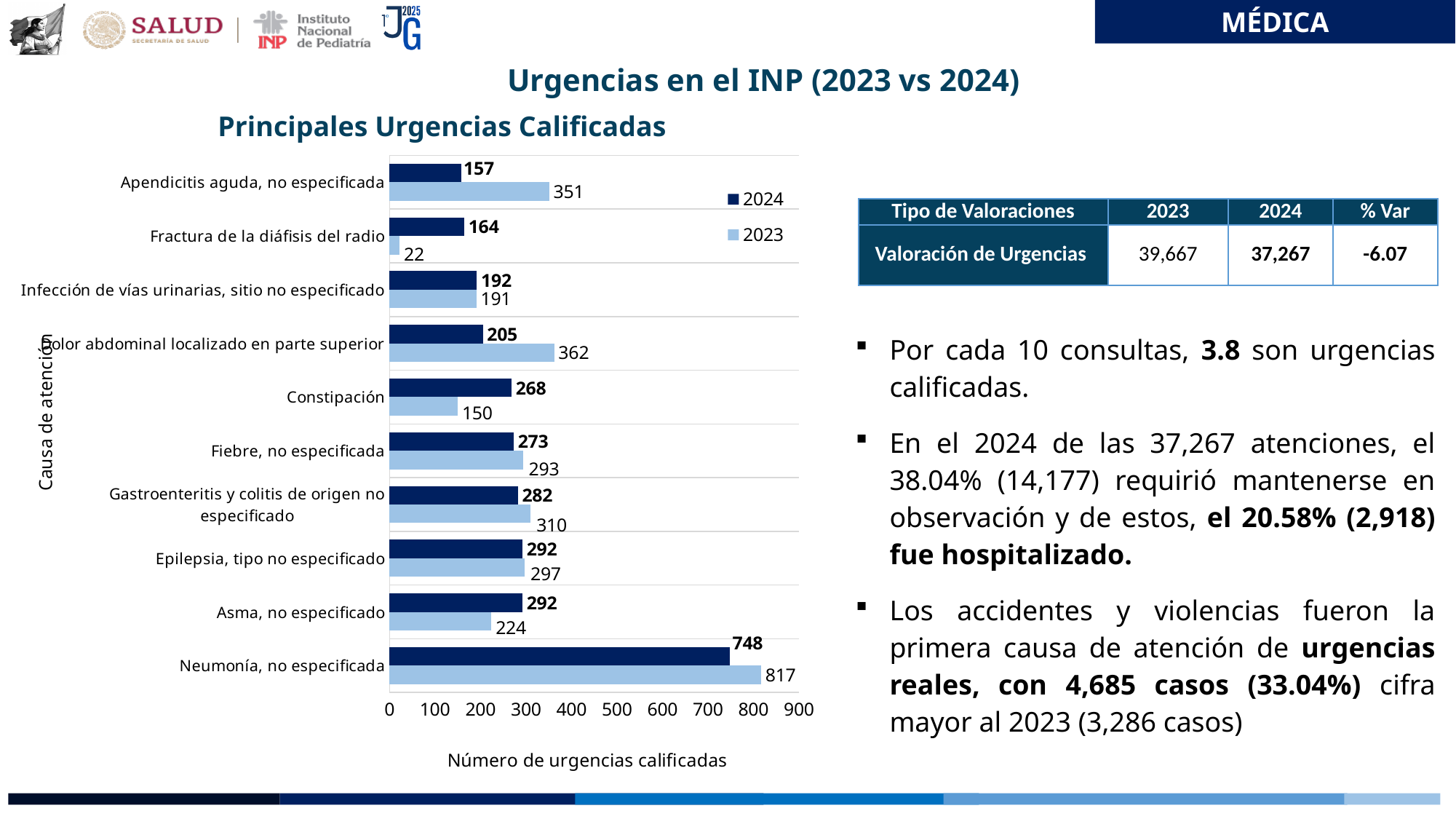
What is the title of the chart? Principales Urgencias Calificadas How many categories (causes of attention) are shown on the chart? 10 What kind of chart is shown on the slide? Bar chart What is the 2023 value for Fractura de la diáfisis del radio? 22 Which category has the highest 2024 value? Neumonía, no especificada How many series does the legend list? 2 Is the 2023 value for Neumonía, no especificada greater or less than 800? greater Which category has the lowest 2023 value? Fractura de la diáfisis del radio What is the 2023 value for Apendicitis aguda, no especificada? 351 What is the 2024 value for Neumonía, no especificada? 748 Which is larger for Constipación, the 2024 value or the 2023 value? 2024 What is the difference between the 2023 and 2024 values for Dolor abdominal localizado en parte superior? 157